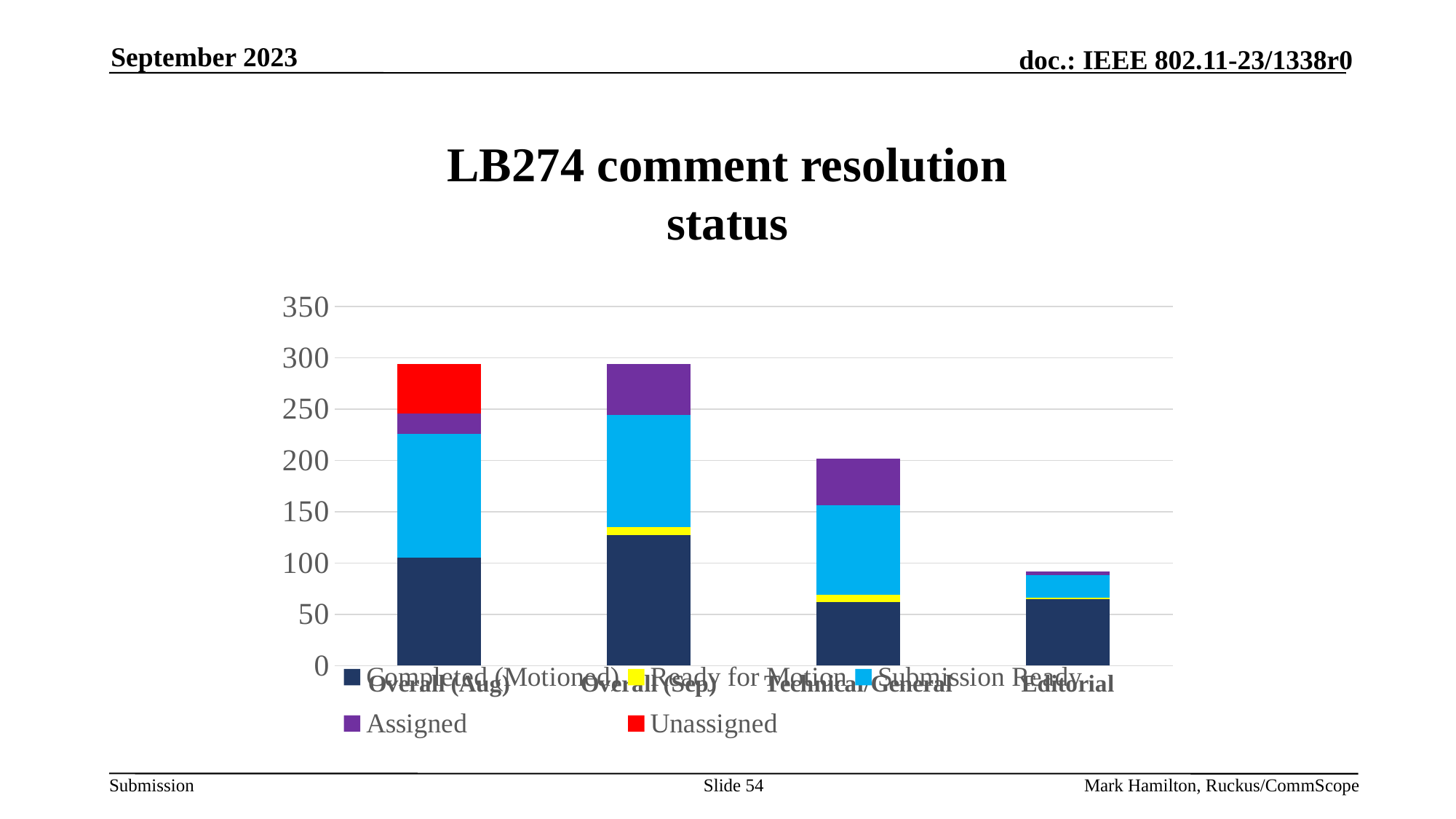
Is the total bar height for Overall (Sep) greater or less than 250? greater Is the Completed (Motioned) segment for Overall (Sep) greater or less than 100? greater Which has the larger total bar, Technical/General or Editorial? Technical/General How many series does the chart's legend list? 5 Is the total bar height for Editorial greater or less than 100? less What is the title of the chart? LB274 comment resolution status Which category is the only one with an Unassigned (red) segment? Overall (Aug) Which category has the lowest total bar height? Editorial What kind of chart is shown on the slide? stacked bar chart How many categories are shown on the x axis of the chart? 4